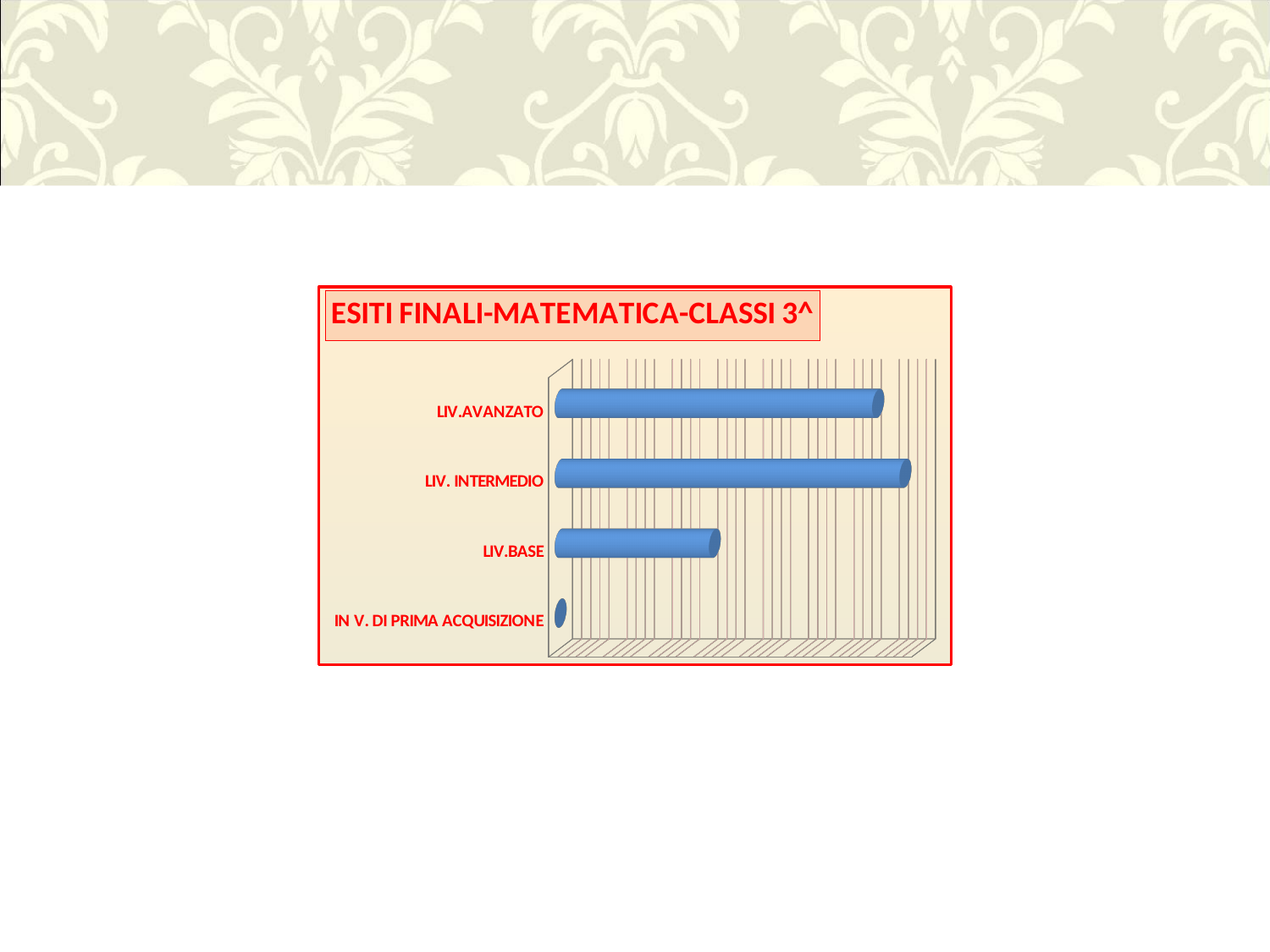
Which is larger, the value for LIV.AVANZATO or the value for LIV.BASE? LIV.AVANZATO Which is larger, the value for LIV.BASE or the value for IN V. DI PRIMA ACQUISIZIONE? LIV.BASE Which is larger, the value for LIV. INTERMEDIO or the value for LIV.AVANZATO? LIV. INTERMEDIO What is the title of the chart? ESITI FINALI-MATEMATICA-CLASSI 3^ Which category has the lowest value? IN V. DI PRIMA ACQUISIZIONE Which category is listed at the top of the chart? LIV.AVANZATO Which category has the second-highest value? LIV.AVANZATO What kind of chart is shown on the slide? bar chart How many categories are plotted in the chart? 4 Which category has the highest value? LIV. INTERMEDIO